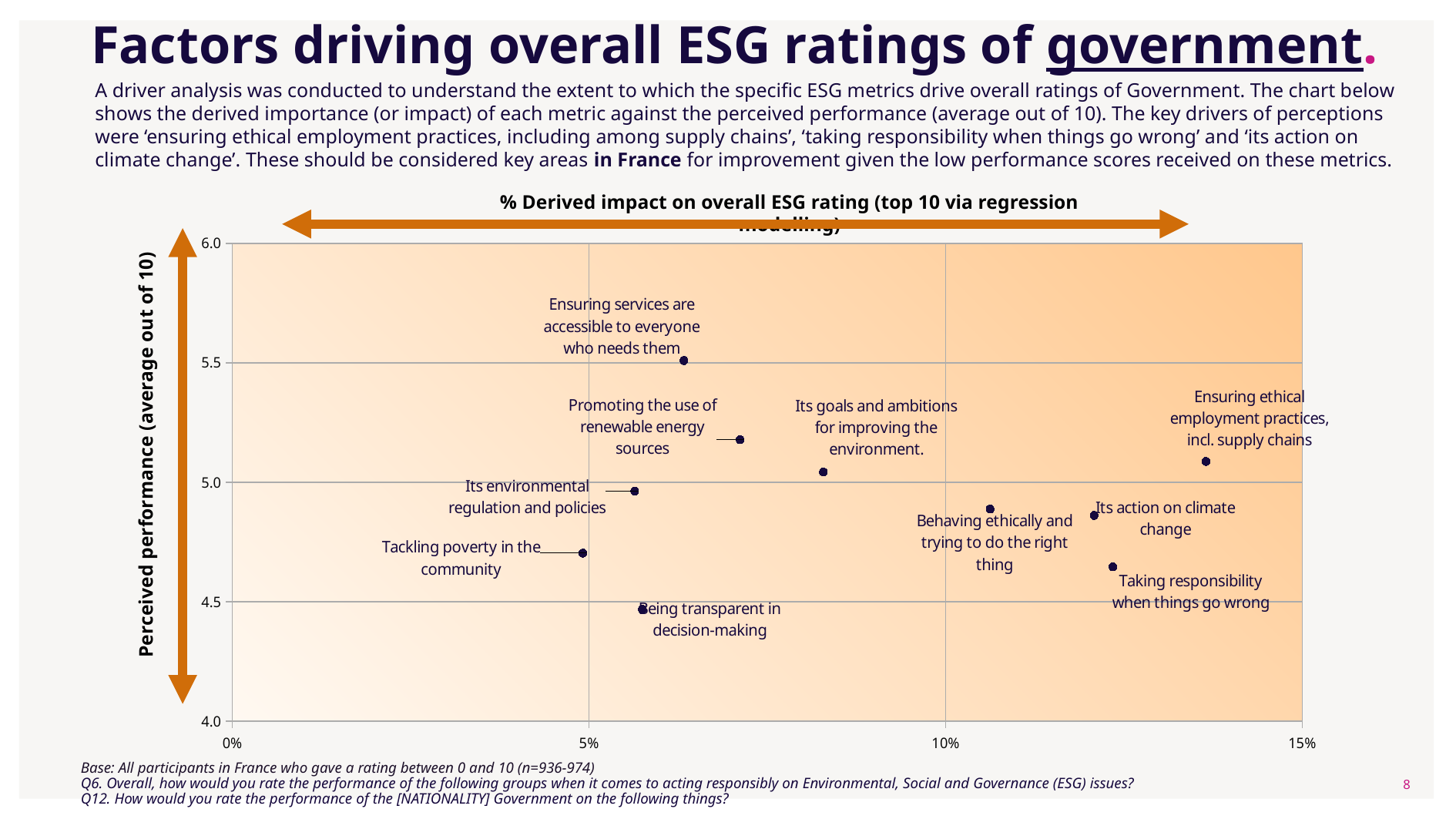
Which factor has the lowest derived impact on the overall ESG rating? Tackling poverty in the community What is the label of the vertical axis of the chart? Perceived performance (average out of 10) What kind of chart is shown on the slide? scatter chart Which has a higher derived impact: 'Taking responsibility when things go wrong' or 'Its environmental regulation and policies'? Taking responsibility when things go wrong Is the derived impact for 'Ensuring ethical employment practices, incl. supply chains' greater or less than 10%? greater Is the perceived performance for 'Being transparent in decision-making' greater or less than 5.0? less Which factor has the highest perceived performance on the chart? Ensuring services are accessible to everyone who needs them Which factor has the highest derived impact on the overall ESG rating? Ensuring ethical employment practices, incl. supply chains Which has a higher perceived performance: 'Promoting the use of renewable energy sources' or 'Tackling poverty in the community'? Promoting the use of renewable energy sources How many data points are plotted on the chart? 10 Which factor has the lowest perceived performance on the chart? Being transparent in decision-making Is the perceived performance for 'Ensuring services are accessible to everyone who needs them' greater or less than 5.0? greater